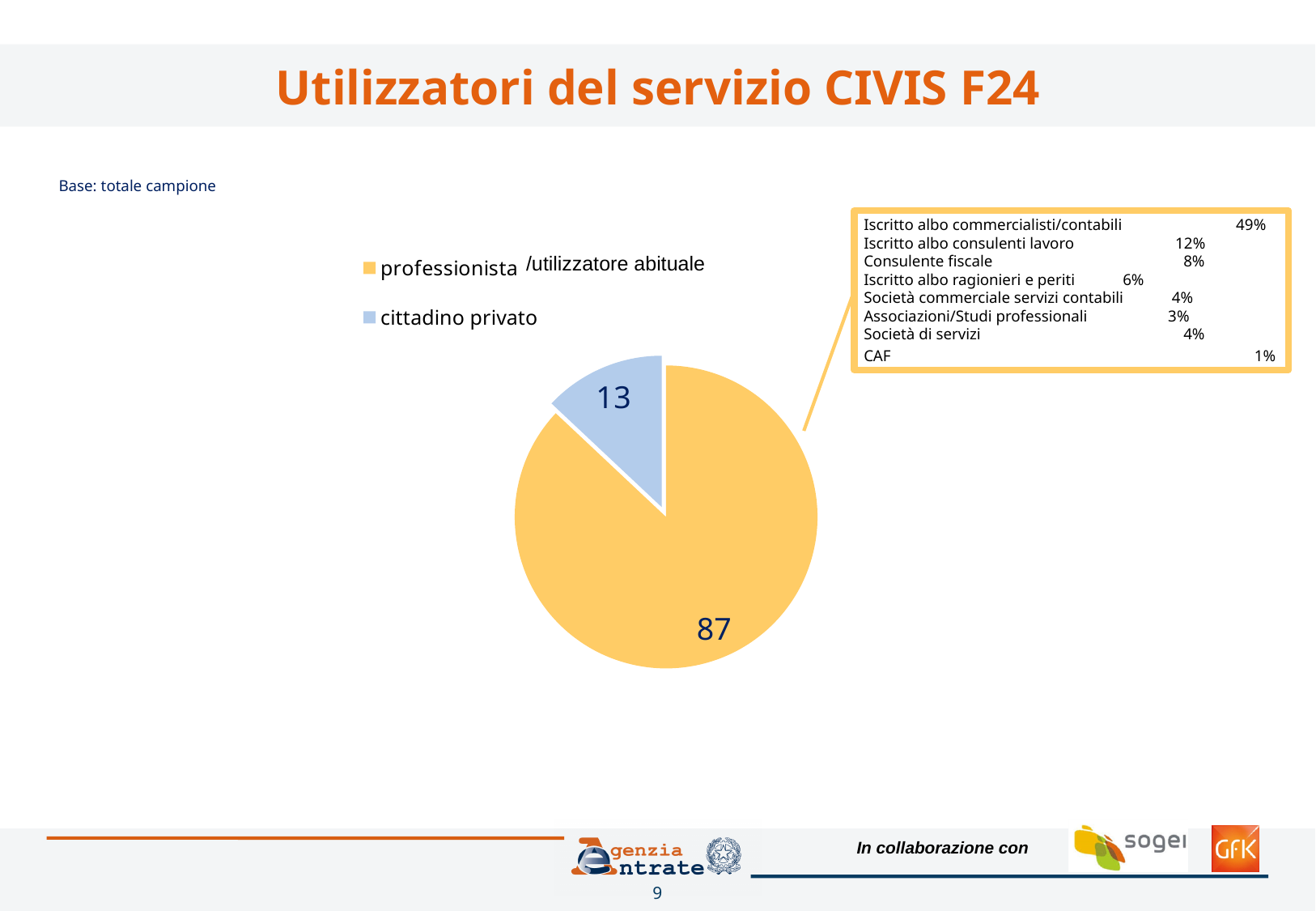
What colour is the 'cittadino privato' slice? light blue What is the value shown for the 'cittadino privato' slice? 13 What is the value shown for the 'professionista /utilizzatore abituale' slice? 87 What is the title of the slide containing the pie chart? Utilizzatori del servizio CIVIS F24 Which slice of the pie is the largest? professionista /utilizzatore abituale How many entries does the legend list? 2 What kind of chart is shown on the slide? pie chart Which is larger, the 'cittadino privato' slice or the 'professionista /utilizzatore abituale' slice? professionista /utilizzatore abituale How many slices does the pie chart have? 2 Which slice of the pie is the smallest? cittadino privato What is the difference between the 'professionista /utilizzatore abituale' value and the 'cittadino privato' value? 74 What is the total of the two pie slice values? 100